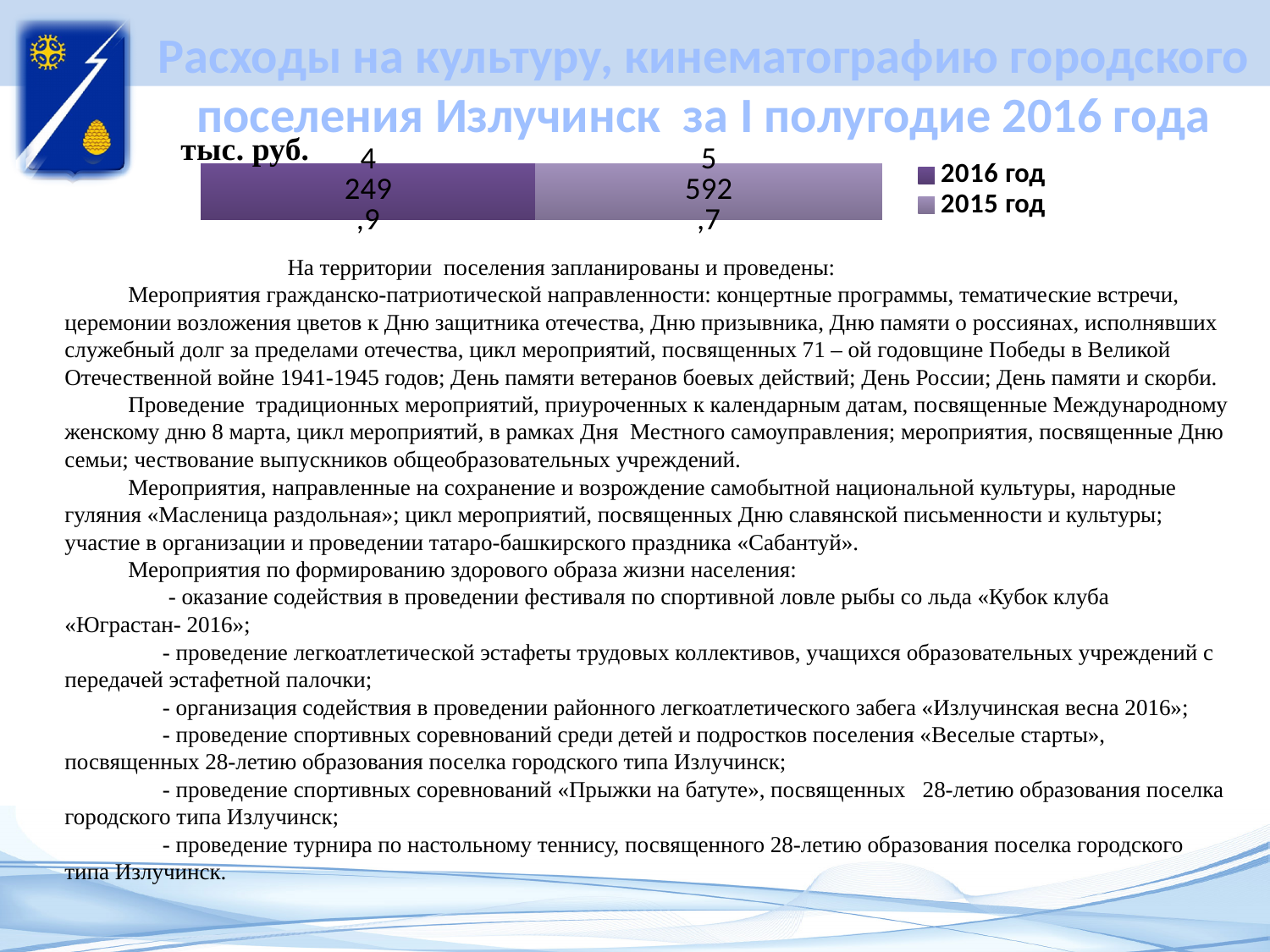
What is the value for 2015 год on the chart? 5 592,7 What unit of measurement is indicated for the chart? тыс. руб. What is the total of the two segments of the stacked bar on the chart? 9 842,6 What is the difference between the values for 2015 год and 2016 год on the chart? 1 342,8 How many series does the legend of the chart list? 2 Which series has the lowest value on the chart? 2016 год Which legend entry is shown in the darker purple colour on the chart? 2016 год Which series has the highest value on the chart? 2015 год What is the value for 2016 год on the chart? 4 249,9 What kind of chart is shown on the slide? Bar chart Which year has the larger value on the chart, 2016 год or 2015 год? 2015 год